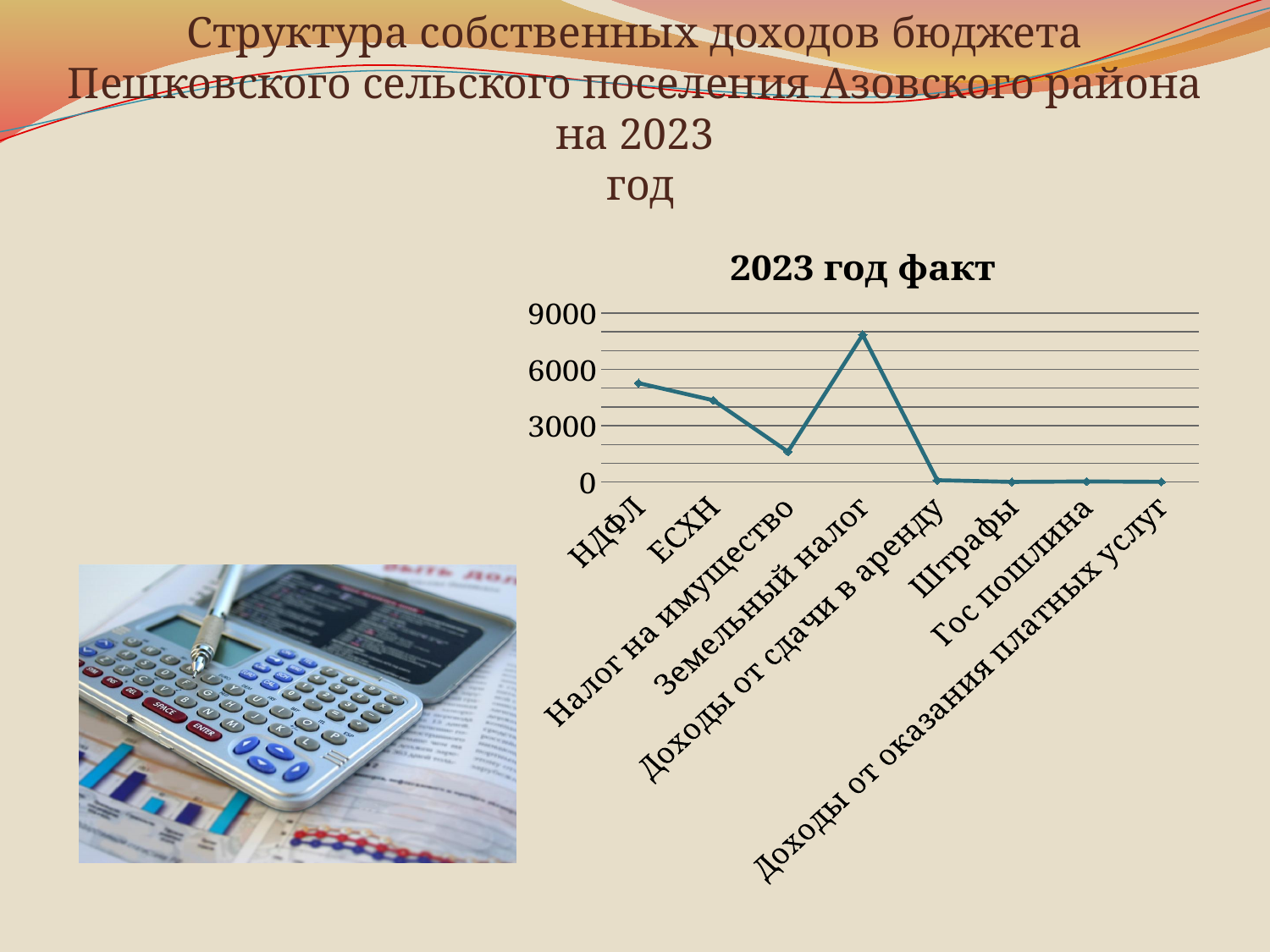
Is the value for Земельный налог greater or less than 6000? greater What is the title of the chart? 2023 год факт How many categories are plotted along the x axis of the chart? 8 Is the value for ЕСХН greater or less than 3000? greater Is the value for НДФЛ greater or less than 6000? less What kind of chart is shown on the slide? line chart Which is larger, the value for НДФЛ or the value for ЕСХН? НДФЛ Which category has the highest value in the chart? Земельный налог Do the values rise or fall from НДФЛ to Налог на имущество? fall Which is larger, the value for Земельный налог or the value for Налог на имущество? Земельный налог